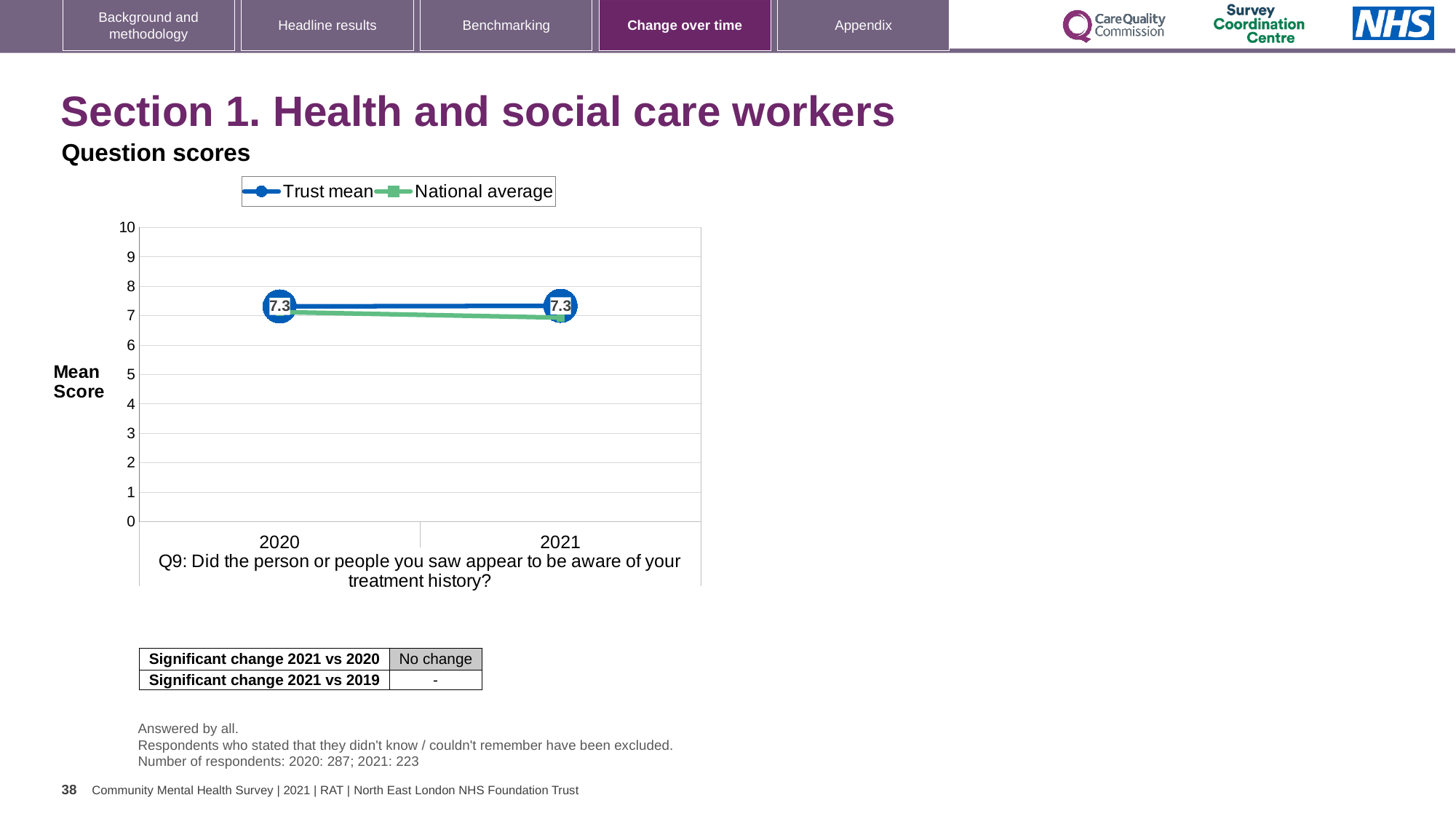
Is the value for the National average in 2020 greater or less than 5? greater What is the difference between the Trust mean in 2021 and in 2020? 0 What is the Trust mean score for 2020? 7.3 What is the Trust mean score for 2021? 7.3 How many series does the legend list? 2 What is the label on the y axis? Mean Score In 2021, which is larger: the Trust mean or the National average? Trust mean Does the Trust mean rise, fall or stay the same from 2020 to 2021? stays the same Does the National average rise or fall from 2020 to 2021? fall What kind of chart is shown? line chart How many years are plotted on the x axis? 2 What are the two series named in the legend? Trust mean and National average